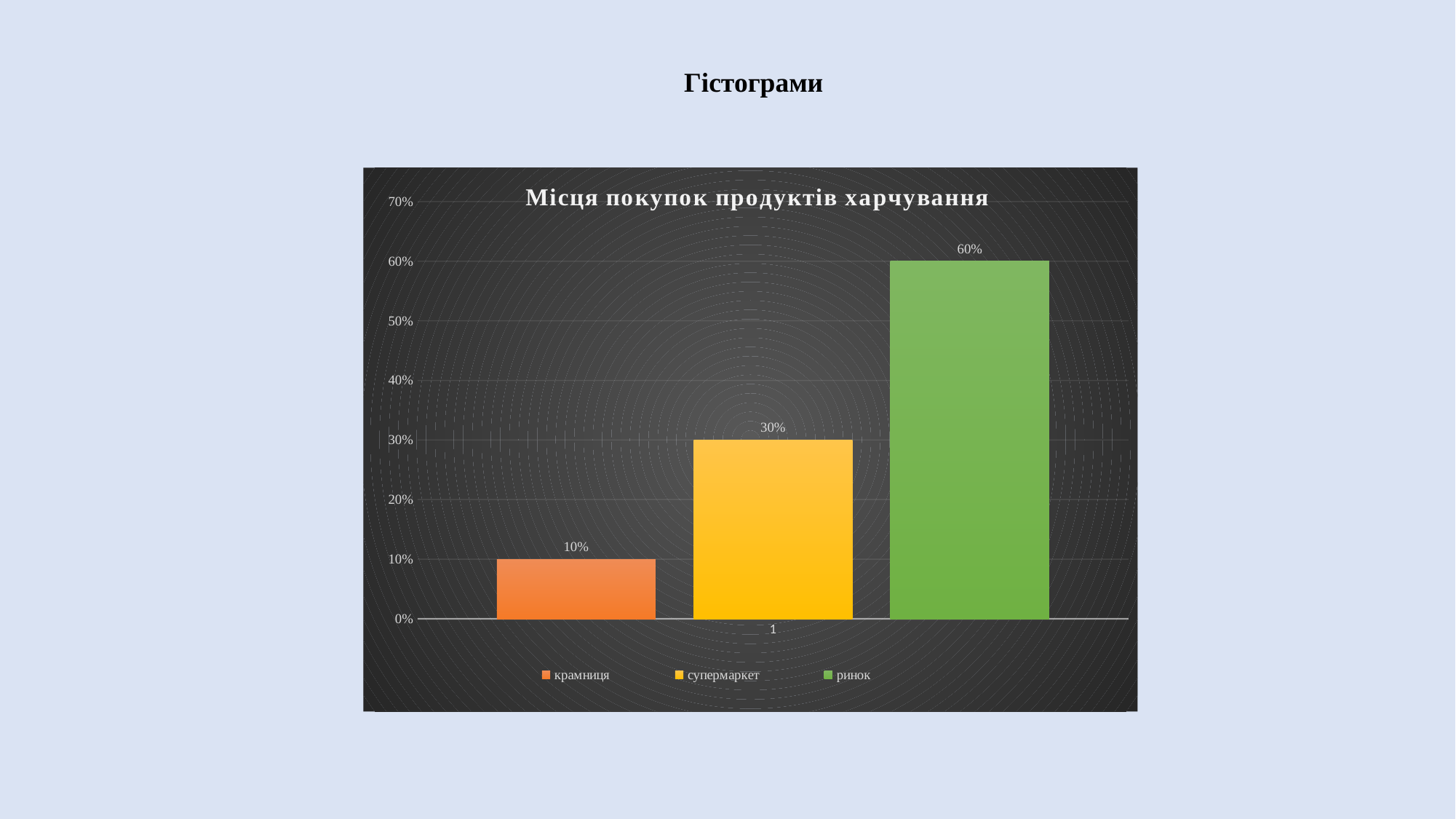
What is the title of the chart? Місця покупок продуктів харчування Which is larger, the value for супермаркет or the value for крамниця? супермаркет What is the difference between the values for ринок and супермаркет? 30% What is the value for крамниця? 10% Which series has the highest value? ринок What kind of chart is shown on the slide? bar chart Which series has the lowest value? крамниця What is the value for супермаркет? 30% What is the difference between the values for супермаркет and крамниця? 20% How many series does the legend list? 3 Is the value for ринок greater or less than 50%? greater What is the value for ринок? 60%